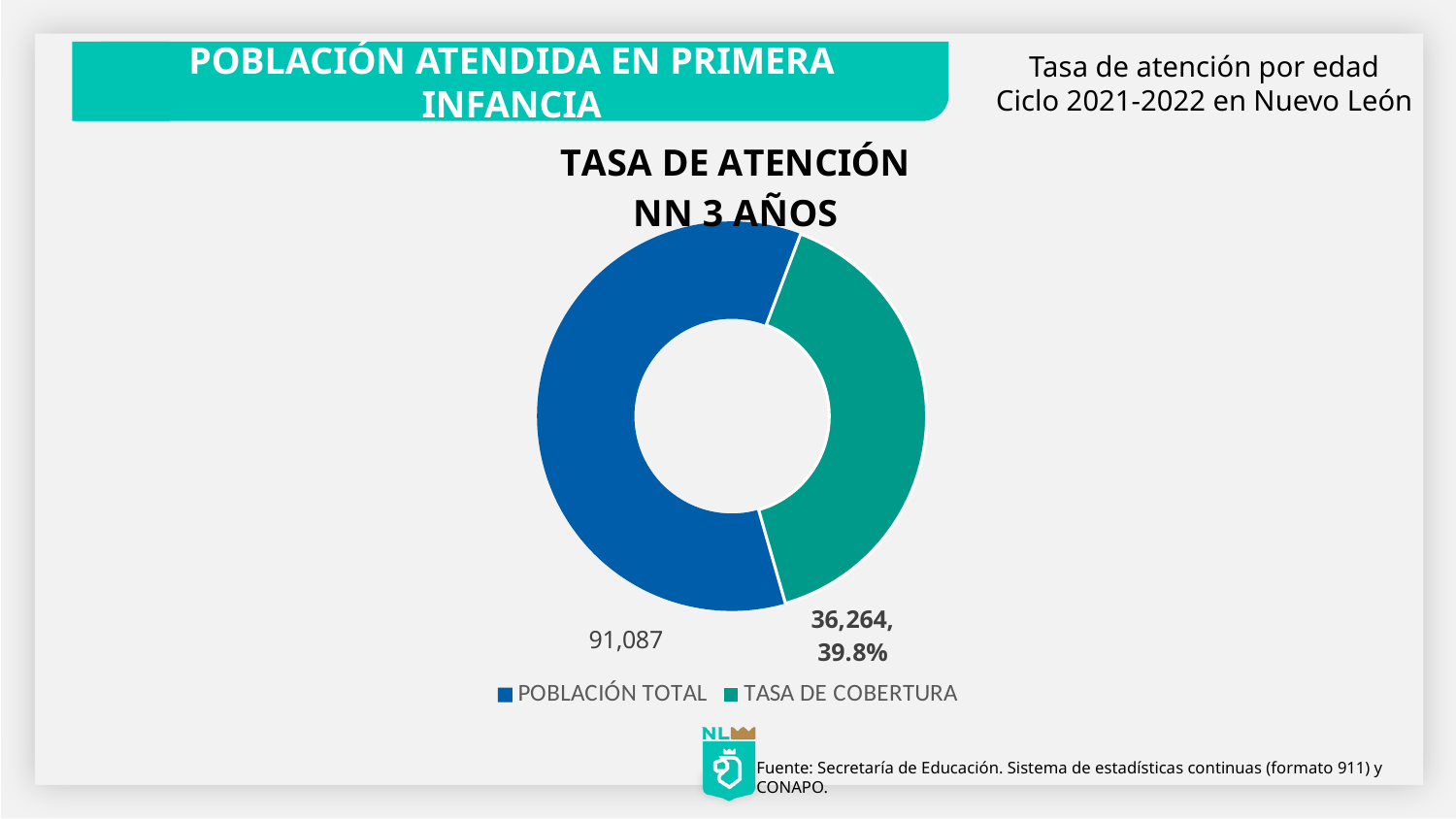
How many slices does the chart have? 2 Which slice is the smallest in the chart? TASA DE COBERTURA What is the value shown for TASA DE COBERTURA? 36,264 What percentage is printed on the TASA DE COBERTURA slice? 39.8% Which is larger, POBLACIÓN TOTAL or TASA DE COBERTURA? POBLACIÓN TOTAL How many entries does the legend list? 2 Which slice is the largest in the chart? POBLACIÓN TOTAL What is the difference between the POBLACIÓN TOTAL value and the TASA DE COBERTURA value? 54,823 What is the value shown for POBLACIÓN TOTAL? 91,087 What is the title of the chart? TASA DE ATENCIÓN NN 3 AÑOS What kind of chart is shown on the slide? Pie chart (doughnut) What colour is the TASA DE COBERTURA slice? Teal (green)